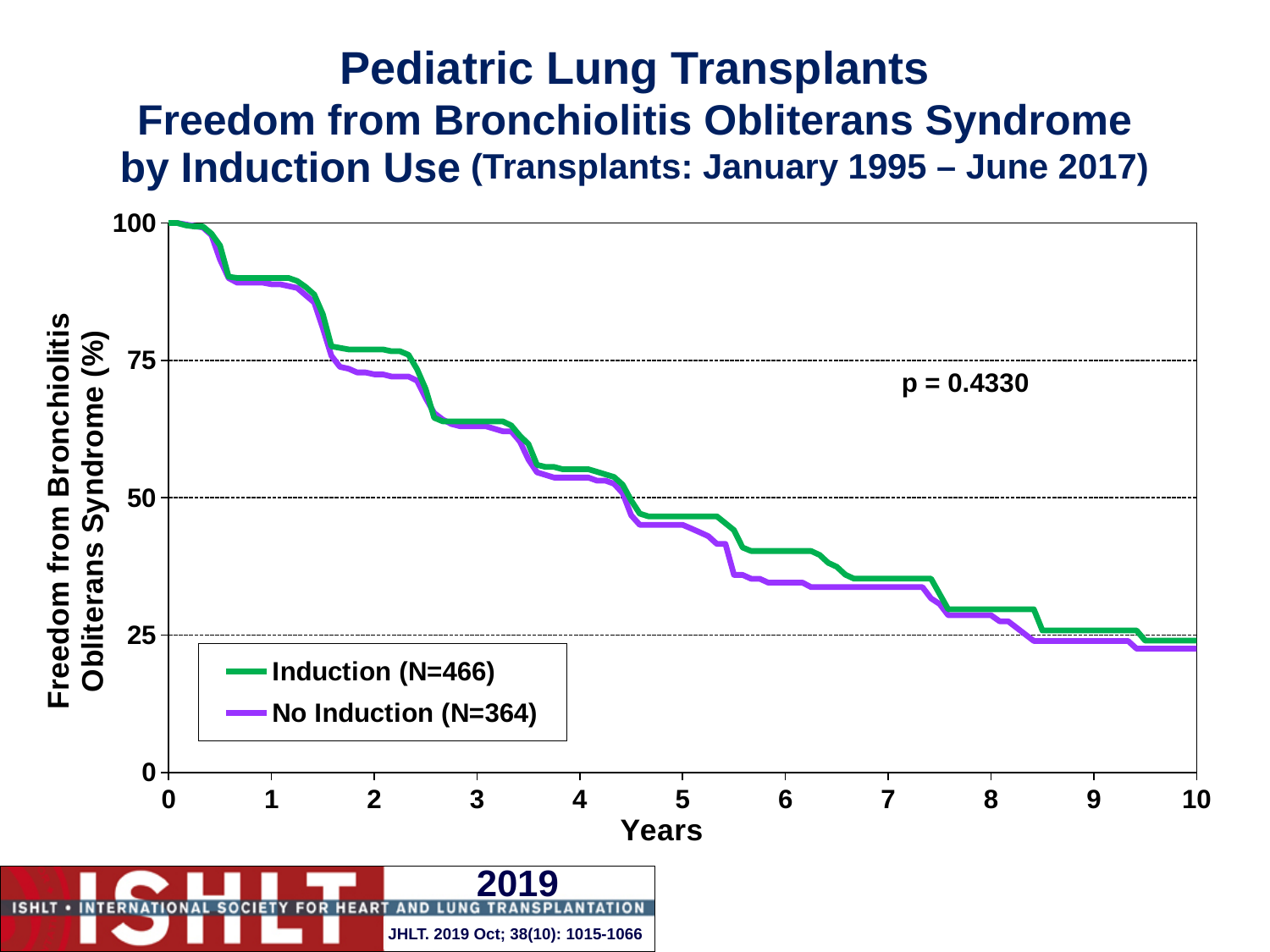
What is the sample size (N) for the Induction group? 466 Is the value for Induction at 5 years greater or less than 50? less Is the value for No Induction at 8 years greater or less than 25? greater What is the sample size (N) for the No Induction group? 364 What p-value is printed on the chart? p = 0.4330 What kind of chart is shown on the slide? Line chart Do the curves rise or fall as years increase? Fall Is the value for No Induction at 3 years greater or less than 50? greater How many series does the legend list? 2 Which colour represents the Induction group? Green At 6 years, which group has the higher freedom from bronchiolitis obliterans syndrome, Induction or No Induction? Induction